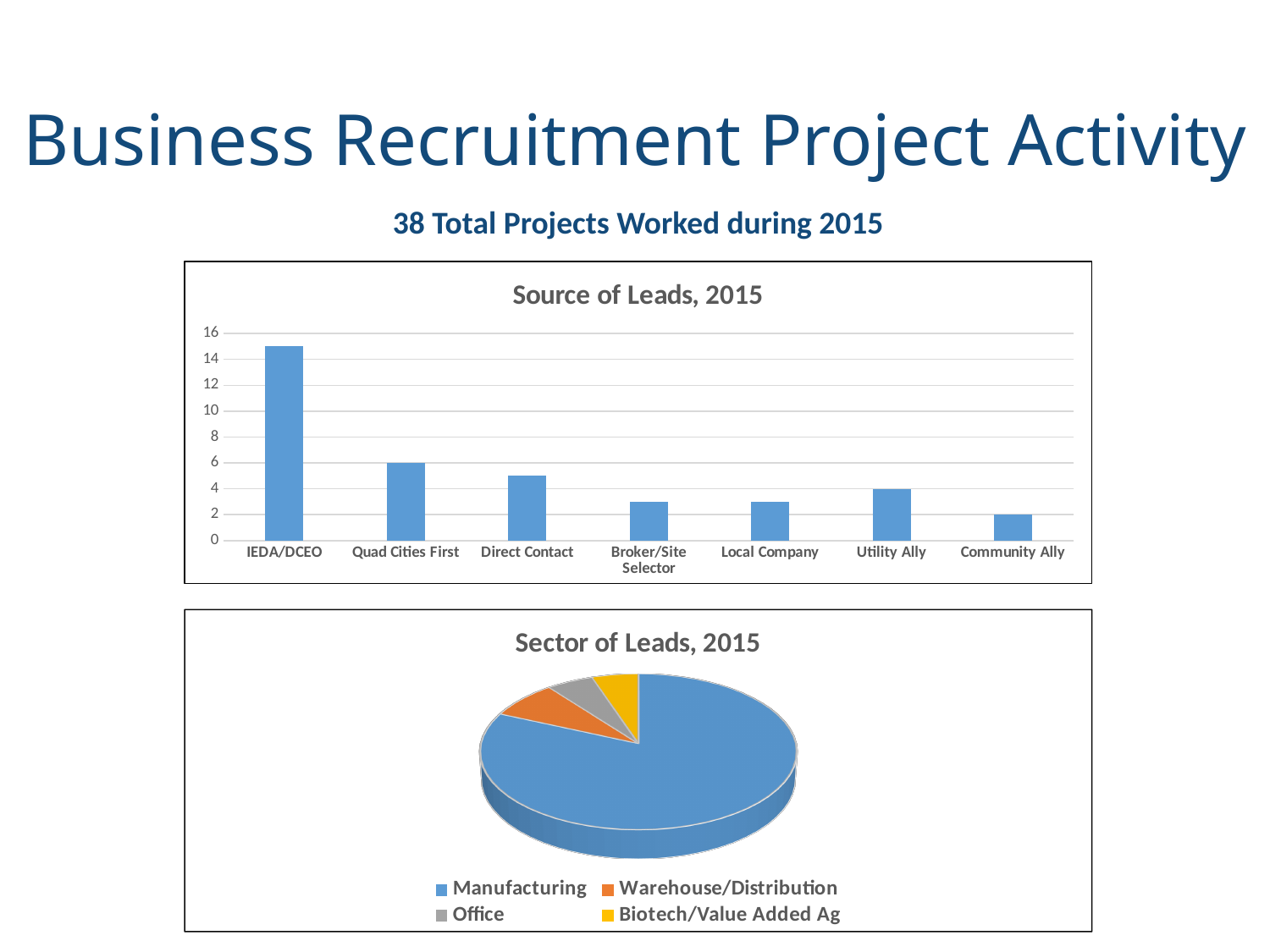
In the 'Source of Leads, 2015' chart, what is the value for Community Ally? 2 In the 'Source of Leads, 2015' chart, what is the value for Quad Cities First? 6 What type of chart is the 'Source of Leads, 2015' chart? bar chart In the 'Source of Leads, 2015' chart, which source has the lowest value? Community Ally In the 'Source of Leads, 2015' chart, is the value for IEDA/DCEO greater or less than 14? greater In the 'Source of Leads, 2015' chart, what is the value for Utility Ally? 4 In the 'Source of Leads, 2015' chart, what is the difference between Quad Cities First and Community Ally? 4 In the 'Sector of Leads, 2015' pie chart, which sector has the largest slice? Manufacturing How many sources are shown in the 'Source of Leads, 2015' chart? 7 In the 'Source of Leads, 2015' chart, which source has the highest value? IEDA/DCEO In the 'Source of Leads, 2015' chart, is the value for Broker/Site Selector greater or less than 4? less In the 'Source of Leads, 2015' chart, which is larger, Quad Cities First or Utility Ally? Quad Cities First